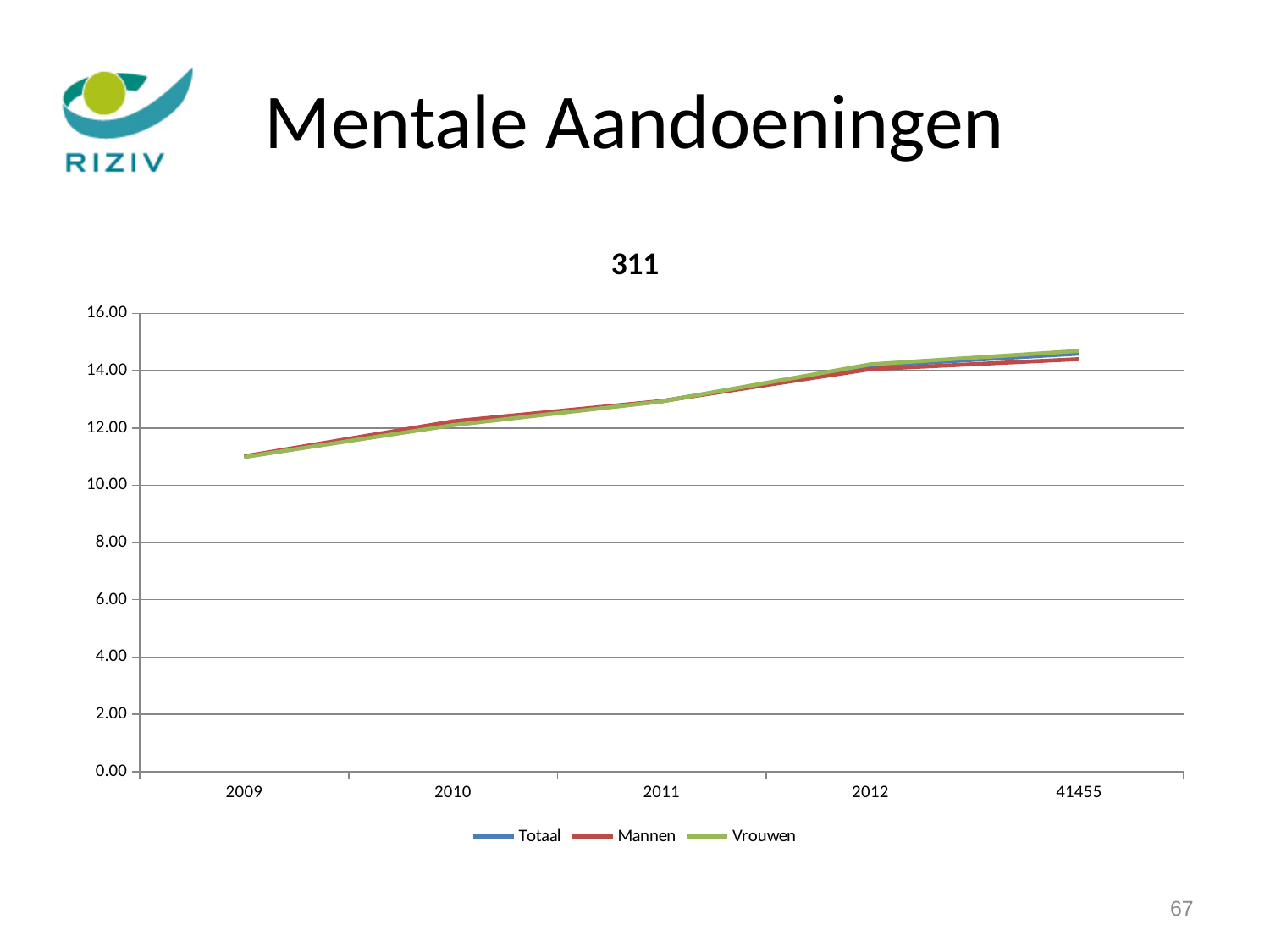
Is the value for Mannen in 2009 greater or less than 10.00? greater How many points are plotted along the x axis? 5 Is the value for Vrouwen at the last x-axis point (41455) greater or less than 14.00? greater Do the values rise or fall from 2009 to the last point on the x axis? rise Is the value for Mannen in 2010 greater or less than 14.00? less Which series are listed in the legend? Totaal, Mannen, Vrouwen What is the title of the chart? 311 What kind of chart is shown on the slide? line chart How many series does the legend list? 3